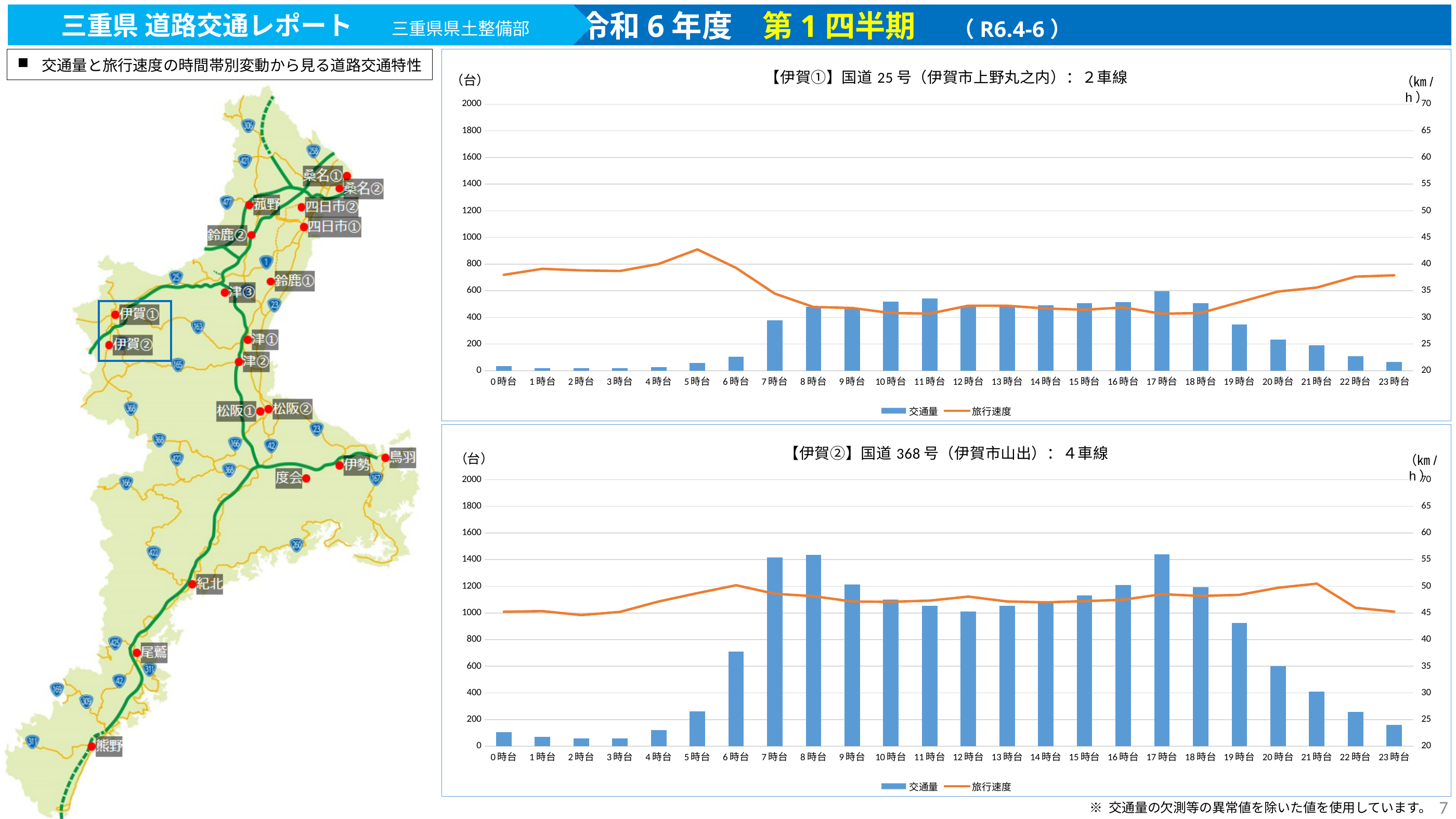
On the 【伊賀①】国道25号 chart, do the 交通量 bars rise or fall from 0時台 to 7時台? rise On the 【伊賀①】国道25号 chart, how many hourly categories are shown on the x axis? 24 On the 【伊賀②】国道368号 chart, do the 交通量 bars rise or fall from 17時台 to 23時台? fall On the 【伊賀②】国道368号 chart, what are the two legend entries? 交通量, 旅行速度 On the 【伊賀②】国道368号 chart, is the 交通量 value for 8時台 greater or less than 1200? greater On the 【伊賀②】国道368号 chart, how many series does the legend list? 2 On the 【伊賀①】国道25号 chart, is the 交通量 value for 19時台 greater or less than 200? greater On the 【伊賀②】国道368号 chart, which has the larger 交通量 bar, 9時台 or 11時台? 9時台 On the 【伊賀②】国道368号 chart, is the 交通量 value for 19時台 greater or less than 1000? less On the 【伊賀①】国道25号 chart, which hour has the highest 交通量 bar? 17時台